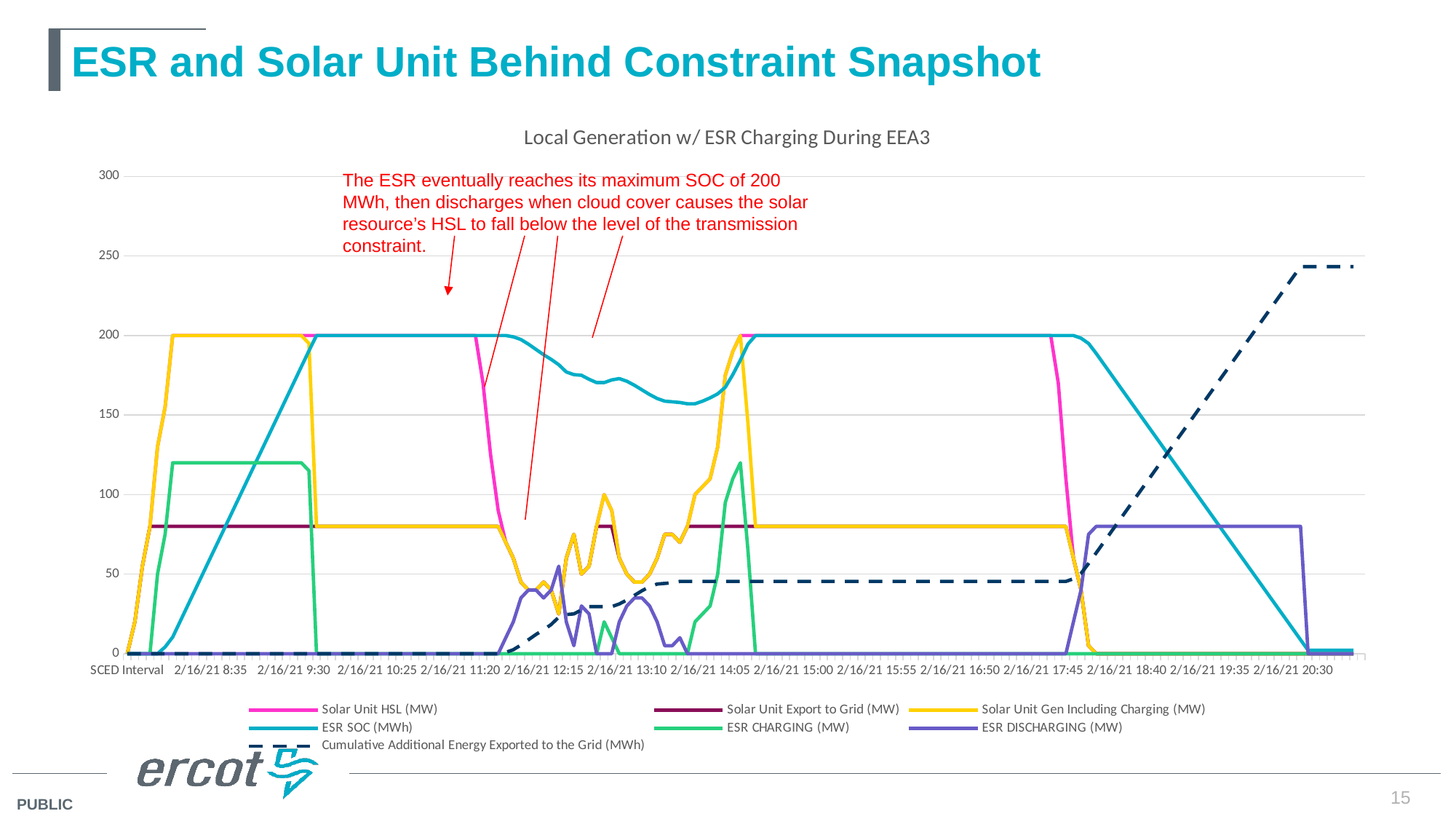
How many series does the chart's legend list? 7 What maximum SOC does the ESR reach, according to the chart annotation? 200 MWh At 2/16/21 15:00, which is larger: ESR SOC (MWh) or Solar Unit Export to Grid (MW)? ESR SOC (MWh) Is the peak value of ESR CHARGING (MW) in the morning (before 2/16/21 9:30) greater or less than 100? greater Is the final value of Cumulative Additional Energy Exported to the Grid (MWh) at the right end of the chart greater or less than 200? greater Is the peak value of ESR DISCHARGING (MW) after 2/16/21 17:45 greater or less than 100? less What kind of chart is shown on the slide? line chart Which series is drawn with a dashed line? Cumulative Additional Energy Exported to the Grid (MWh) What is the title of the chart? Local Generation w/ ESR Charging During EEA3 Does the Cumulative Additional Energy Exported to the Grid (MWh) series rise or fall over the course of the day? rise